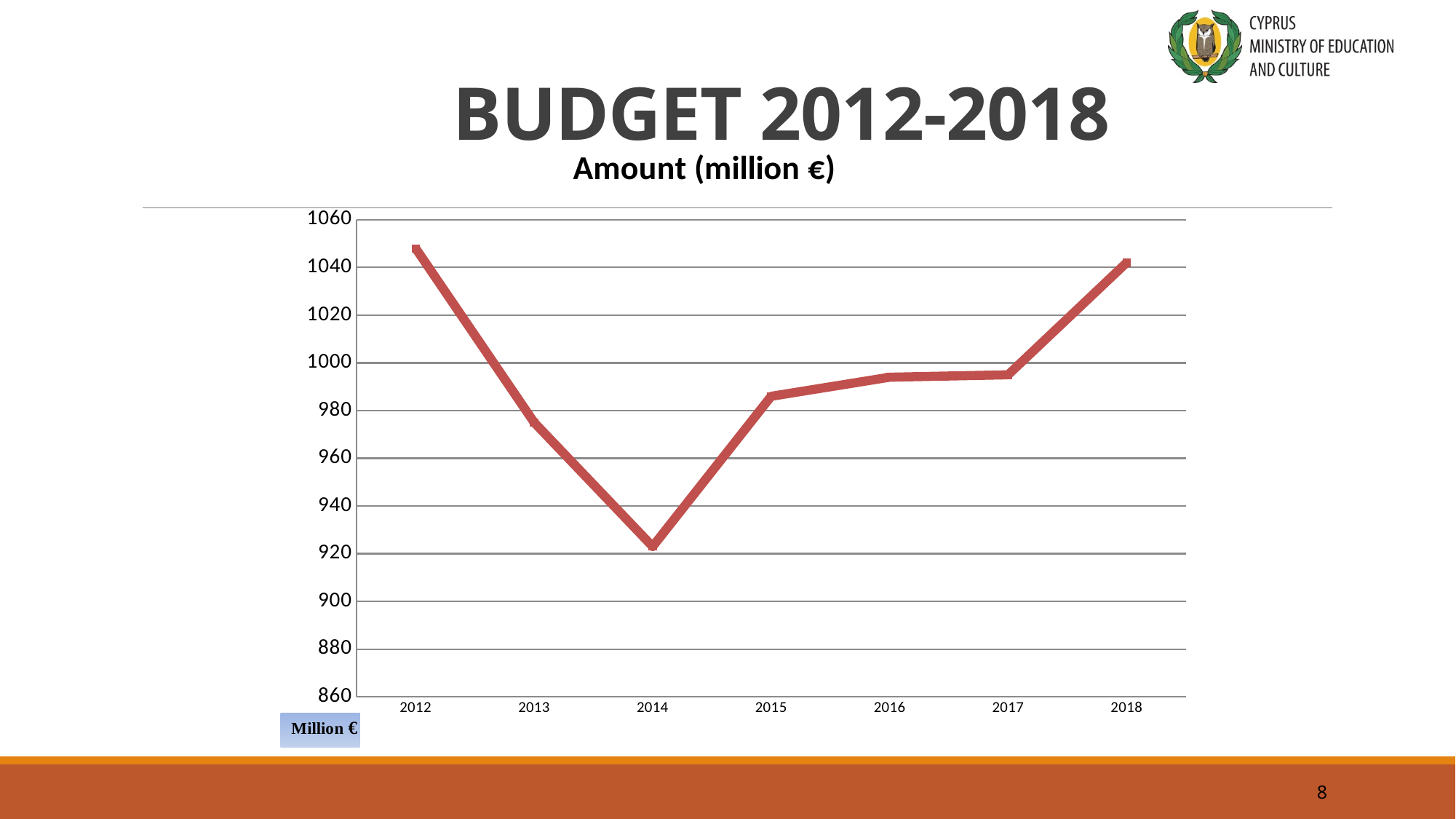
How many years are plotted on the x axis of the chart? 7 What is the title shown above the chart's plot area? Amount (million €) What kind of chart is shown on the slide? line chart Which is larger, the value for 2013 or the value for 2015? 2015 Is the value for 2013 greater or less than 980? less Do the values rise or fall from 2012 to 2014? fall Is the value for 2016 greater or less than 1000? less Is the value for 2012 greater or less than 1040? greater Which year has the lowest budget amount in the chart? 2014